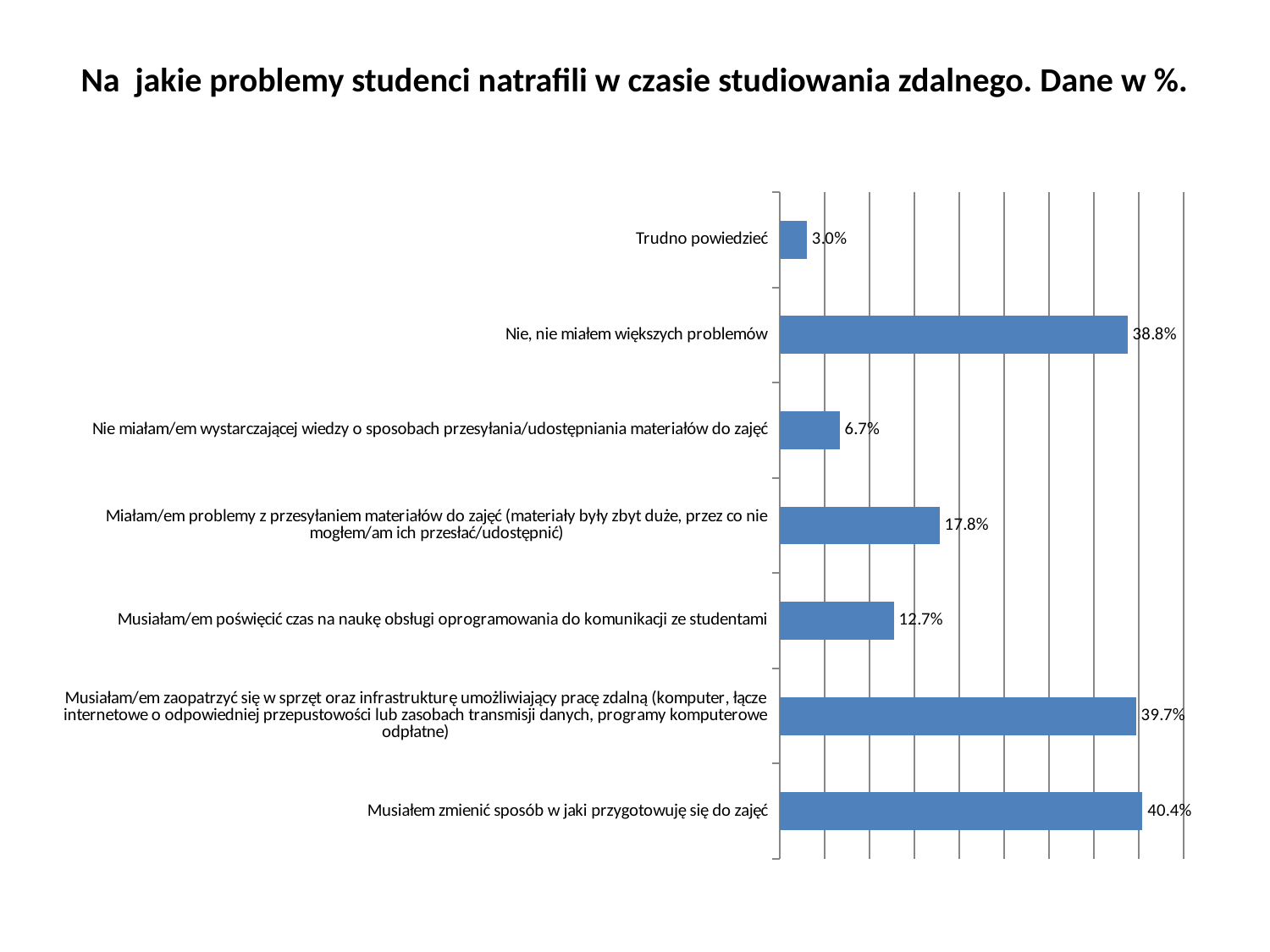
Which category has the highest value? Musiałem zmienić sposób w jaki przygotowuję się do zajęć What is the title of the slide? Na jakie problemy studenci natrafili w czasie studiowania zdalnego. Dane w %. Which is larger: the value for "Nie, nie miałem większych problemów" or the value for "Miałam/em problemy z przesyłaniem materiałów do zajęć"? Nie, nie miałem większych problemów What is the value for "Musiałem zmienić sposób w jaki przygotowuję się do zajęć"? 40.4% What is the difference between the values for "Musiałem zmienić sposób w jaki przygotowuję się do zajęć" and "Musiałam/em zaopatrzyć się w sprzęt oraz infrastrukturę umożliwiający pracę zdalną"? 0.7% What is the difference between the values for "Miałam/em problemy z przesyłaniem materiałów do zajęć" and "Musiałam/em poświęcić czas na naukę obsługi oprogramowania do komunikacji ze studentami"? 5.1% How many categories are plotted in the chart? 7 What is the value for "Nie, nie miałem większych problemów"? 38.8% What is the value for "Trudno powiedzieć"? 3.0% What kind of chart is shown on the slide? bar chart Which category has the lowest value? Trudno powiedzieć What is the value for "Musiałam/em poświęcić czas na naukę obsługi oprogramowania do komunikacji ze studentami"? 12.7%